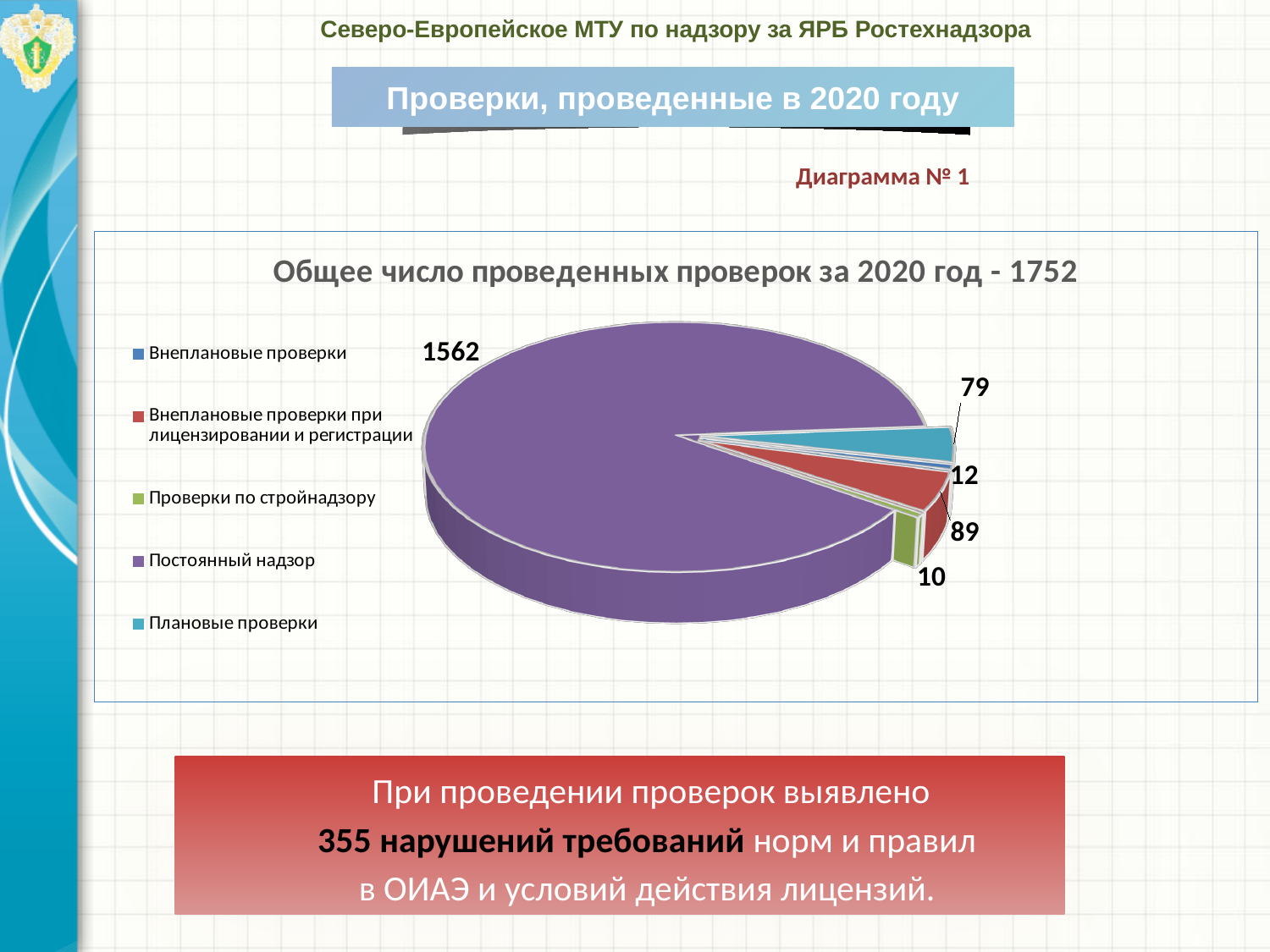
What is the title of the chart? Общее число проведенных проверок за 2020 год - 1752 What type of chart is shown on the slide? pie chart What is the value for Внеплановые проверки? 12 What is the value for Плановые проверки? 79 Which category has the largest slice of the pie? Постоянный надзор What is the value for Проверки по стройнадзору? 10 What is the value for Постоянный надзор? 1562 Which category has the smallest value? Проверки по стройнадзору What is the difference between the values for Внеплановые проверки при лицензировании и регистрации and Плановые проверки? 10 Which is larger: Плановые проверки or Внеплановые проверки? Плановые проверки What is the value for Внеплановые проверки при лицензировании и регистрации? 89 How many categories does the legend list? 5